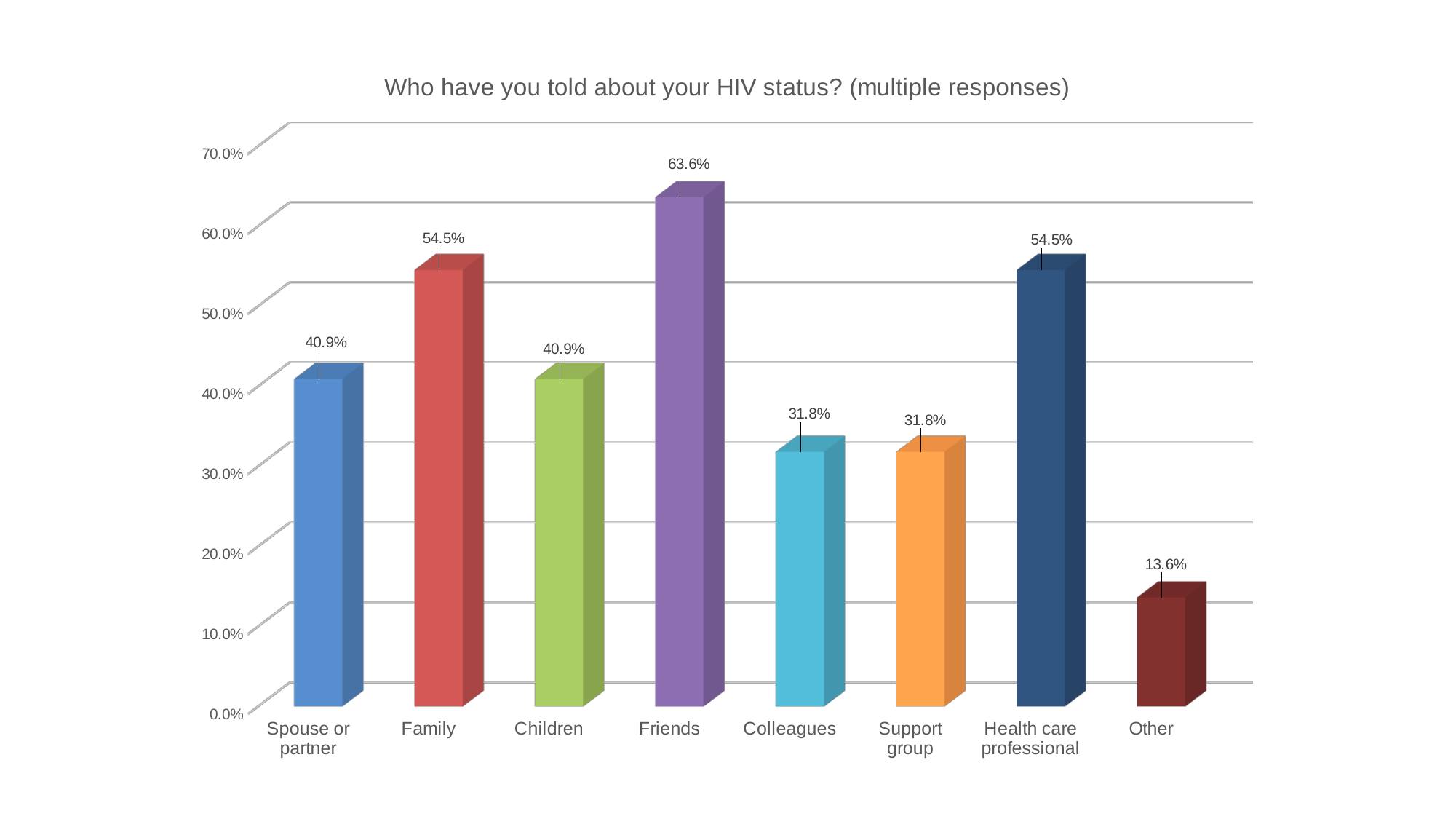
What is the value for Health care professional? 54.5% How many categories are shown on the x axis? 8 What is the value for Other? 13.6% What is the value for Support group? 31.8% Which category has the lowest value? Other Is the value for Children greater or less than 50.0%? less What is the difference between the values for Spouse or partner and Other? 27.3% What is the difference between the values for Friends and Family? 9.1% Which is larger, the value for Family or the value for Colleagues? Family Which category has the highest value? Friends What percentage of respondents said they told Friends about their HIV status? 63.6% What kind of chart is shown on the slide? Bar chart